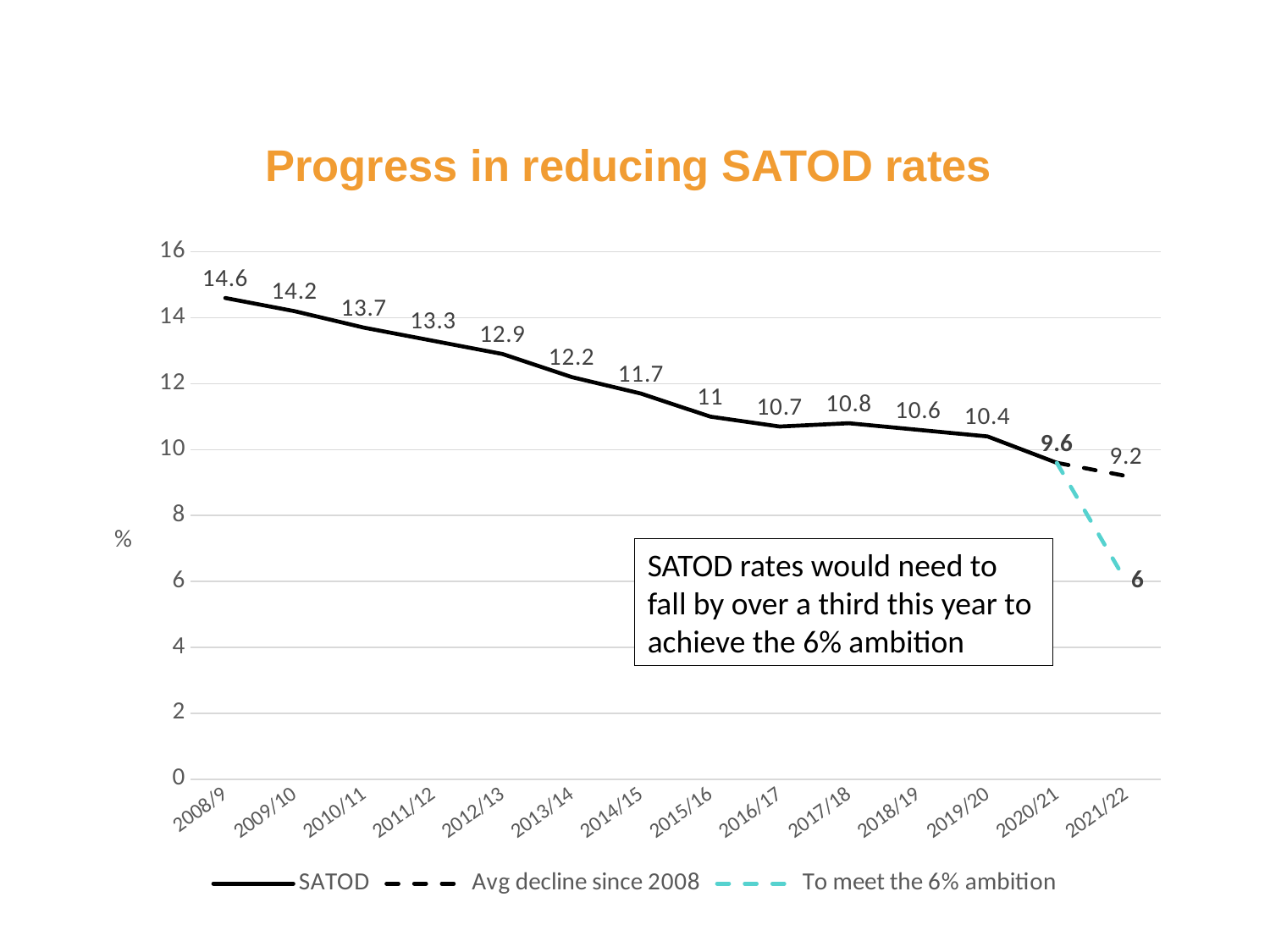
What value does the 'Avg decline since 2008' line reach in 2021/22? 9.2 Which is larger, the SATOD rate in 2016/17 or in 2017/18? 2017/18 What value does the 'To meet the 6% ambition' line reach in 2021/22? 6 How many series does the legend list? 3 What is the difference between the SATOD rate in 2008/9 and in 2020/21? 5 Which year has the highest SATOD rate? 2008/9 How many years are shown on the x axis? 14 What is the SATOD rate for 2008/9? 14.6 What kind of chart is this? line chart Is the SATOD rate for 2015/16 greater or less than 12? less What is the SATOD rate for 2020/21? 9.6 Does the SATOD rate rise or fall from 2008/9 to 2020/21? fall